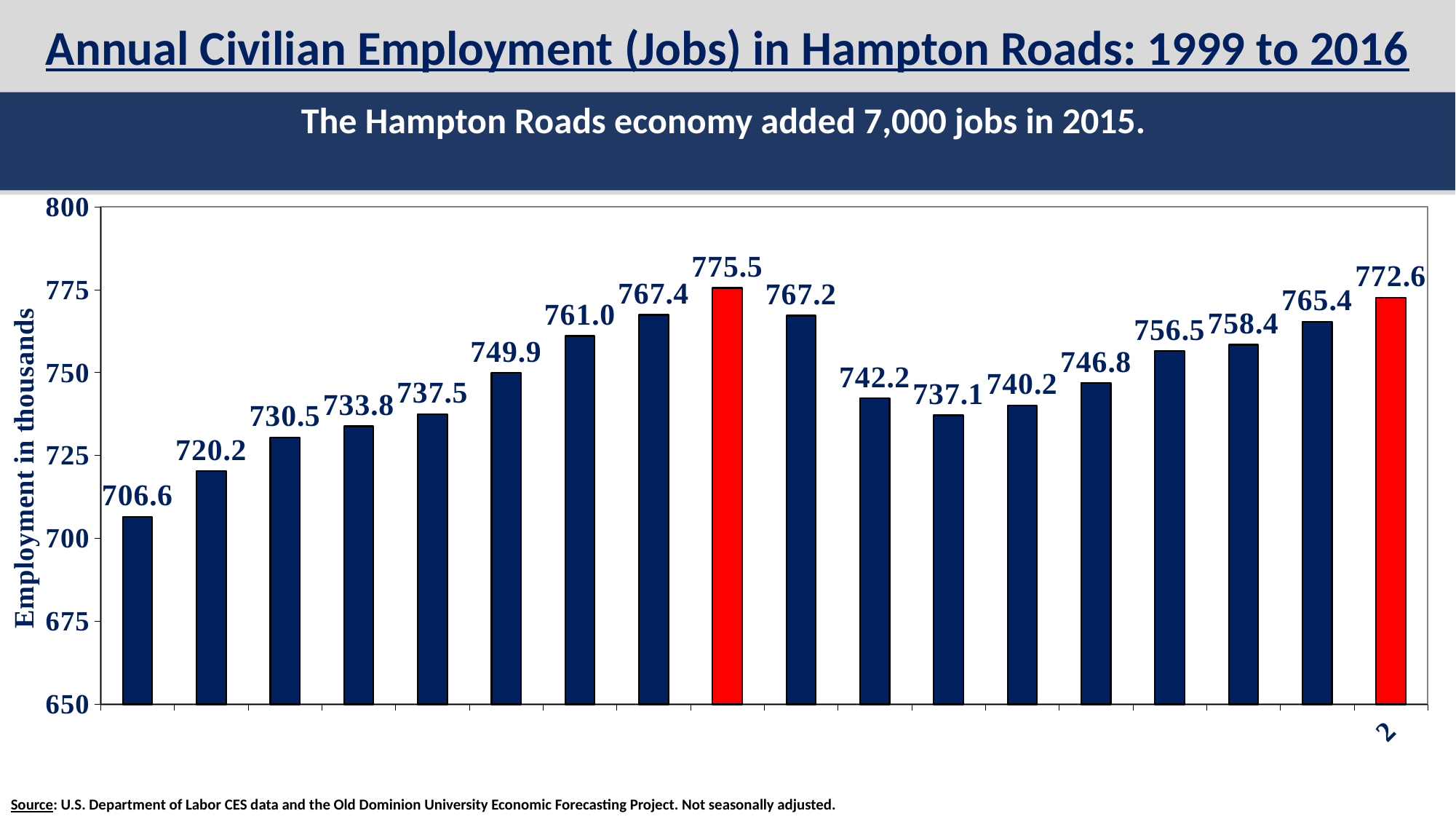
Which is larger, the bar labelled 761.0 or the bar labelled 742.2? 761.0 What is the difference between the values of the two red bars? 2.9 What is the difference between the value of the last bar (772.6) and the first bar (706.6)? 66.0 What is the value of the last (rightmost) bar in the chart? 772.6 What is the lowest value shown in the chart? 706.6 Is the value of the second bar from the left greater or less than 725? less How many bars are plotted in the chart? 18 What is the label on the vertical axis of the chart? Employment in thousands What kind of chart is shown on the slide? bar chart What is the value of the bar immediately to the right of the tallest bar? 767.2 What is the highest value shown in the chart? 775.5 Do the values rise or fall from the first bar to the ninth bar? rise